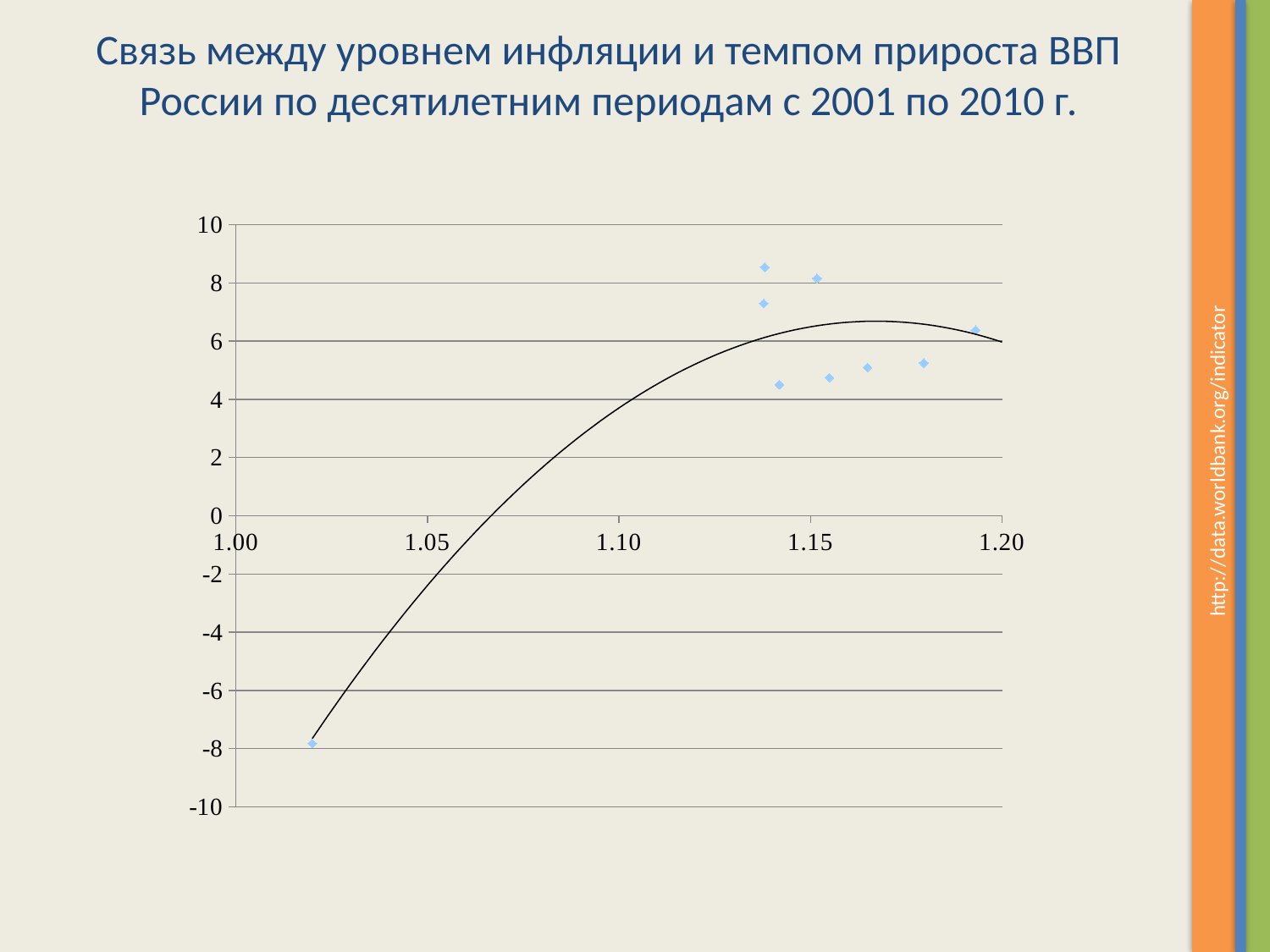
Is the x value of the lowest point on the chart greater or less than 1.05? less Is the y value of the lowest point on the chart greater or less than -6? less What is the minimum value shown on the y axis? -10 What is the largest value shown on the x axis? 1.20 What is the maximum value shown on the y axis? 10 What is the title of the chart on the slide? Связь между уровнем инфляции и темпом прироста ВВП России по десятилетним периодам с 2001 по 2010 г. Does the fitted curve rise or fall as x increases from 1.00 to 1.15? rise What kind of chart is shown on the slide? scatter chart Which is larger: the y value of the lowest point (near x = 1.02) or the y value of the rightmost point (near x = 1.19)? the rightmost point Is the y value of the rightmost data point (near x = 1.19) greater or less than 6? greater How many data points on the chart have a y value below 0? 1